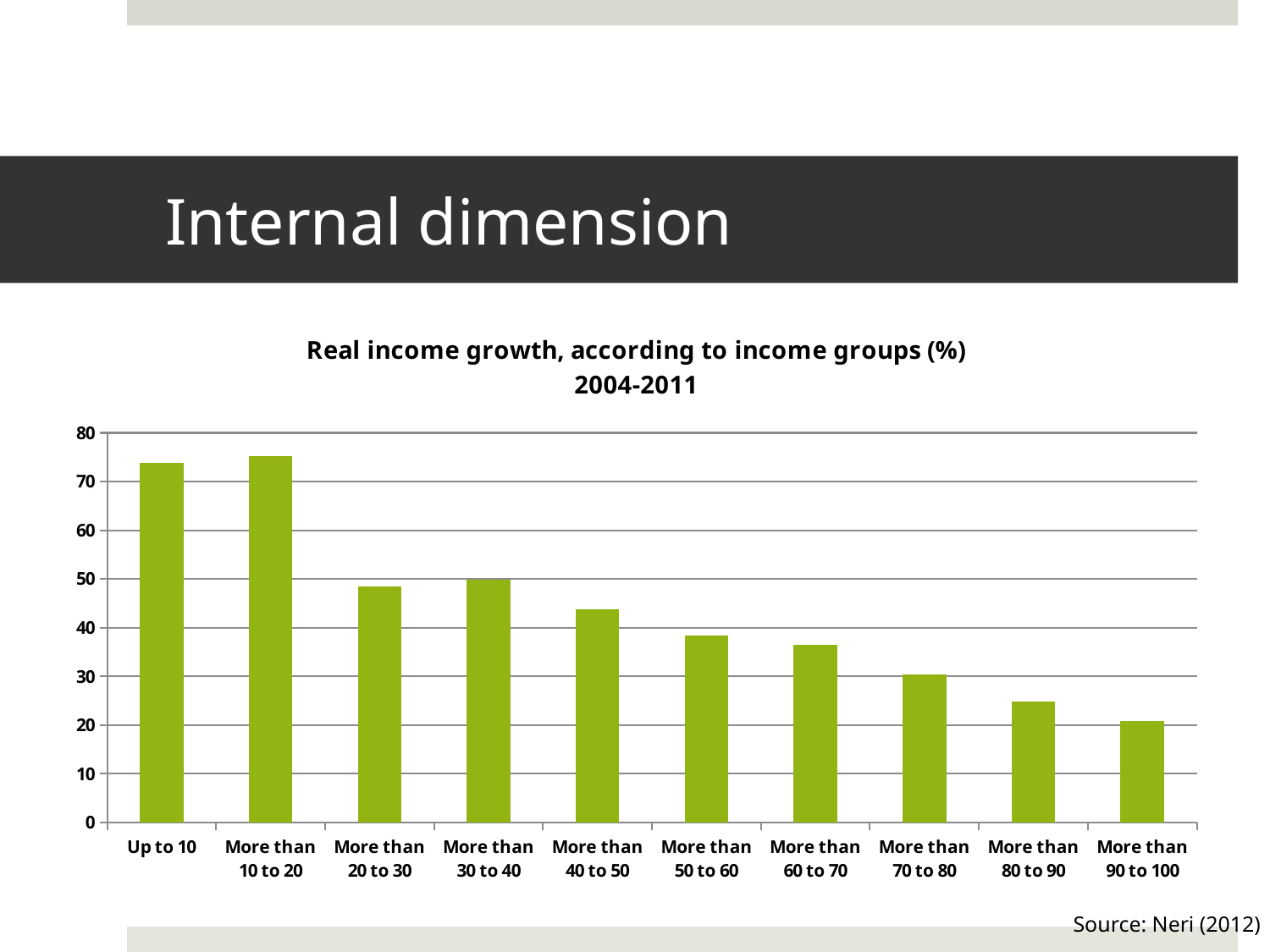
What is the title of the chart? Real income growth, according to income groups (%) 2004-2011 Is the value for "More than 60 to 70" greater or less than 40? less Is the value for "Up to 10" greater or less than 70? greater Do the values generally rise or fall as the income groups move from left to right along the x axis? Fall Which has the larger value: "Up to 10" or "More than 20 to 30"? Up to 10 Is the value for "More than 80 to 90" greater or less than 20? greater Which has the larger value: "More than 40 to 50" or "More than 80 to 90"? More than 40 to 50 What kind of chart is shown on the slide? Bar chart Which income group has the lowest real income growth in the chart? More than 90 to 100 How many income groups are shown on the x axis of the chart? 10